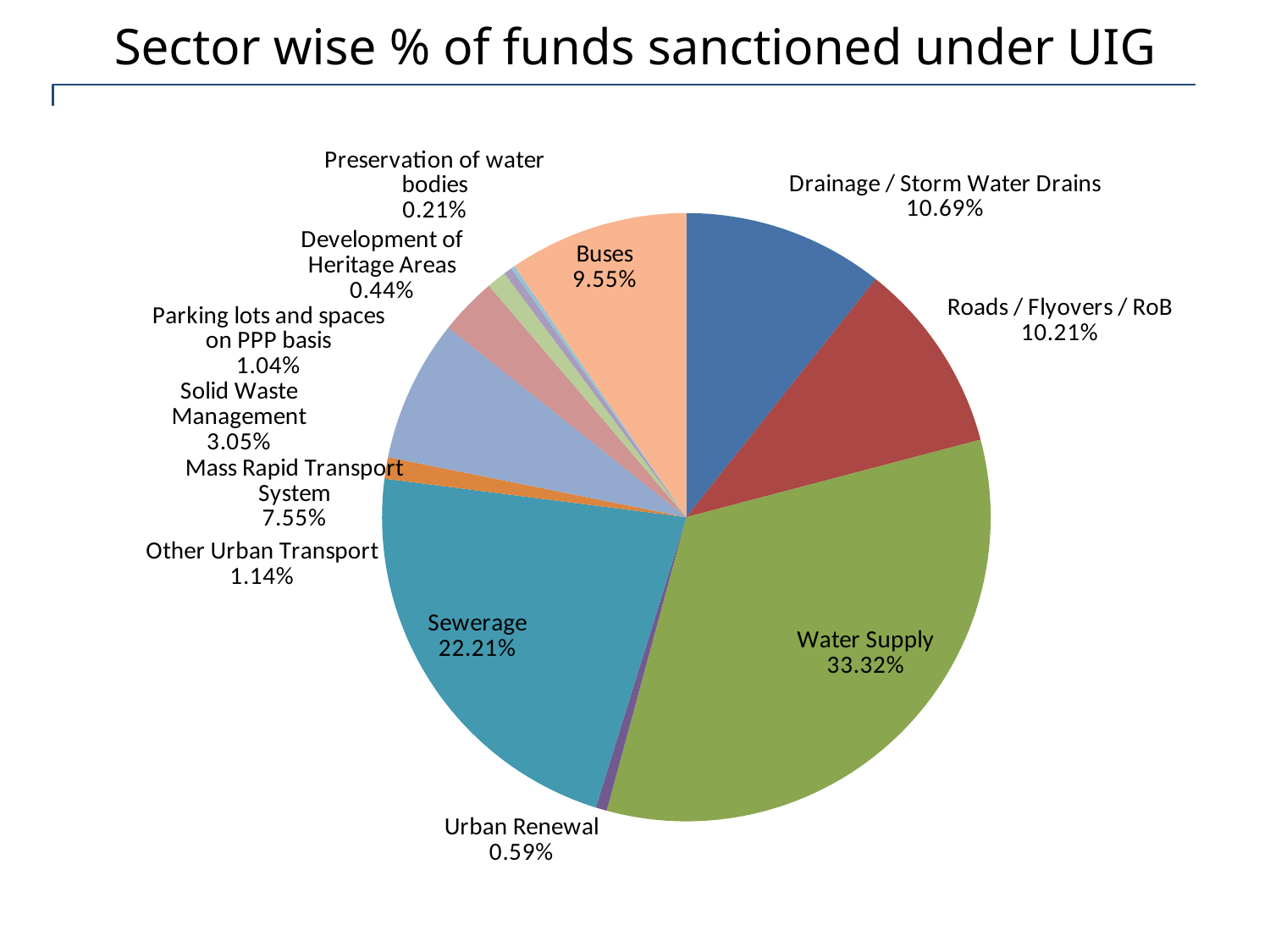
How many sectors are shown in the pie chart? 12 What percentage of funds was sanctioned for Mass Rapid Transport System? 7.55% What percentage of funds was sanctioned for Water Supply? 33.32% What is the combined share of Drainage / Storm Water Drains and Roads / Flyovers / RoB? 20.90% What percentage of funds was sanctioned for Preservation of water bodies? 0.21% What is the title of the chart? Sector wise % of funds sanctioned under UIG Which sector received the largest share of funds? Water Supply Which sector received the smallest share of funds? Preservation of water bodies What percentage of funds was sanctioned for Sewerage? 22.21% What is the difference in percentage points between Water Supply and Sewerage? 11.11 Which received a larger share of funds, Drainage / Storm Water Drains or Buses? Drainage / Storm Water Drains What kind of chart is shown on the slide? Pie chart